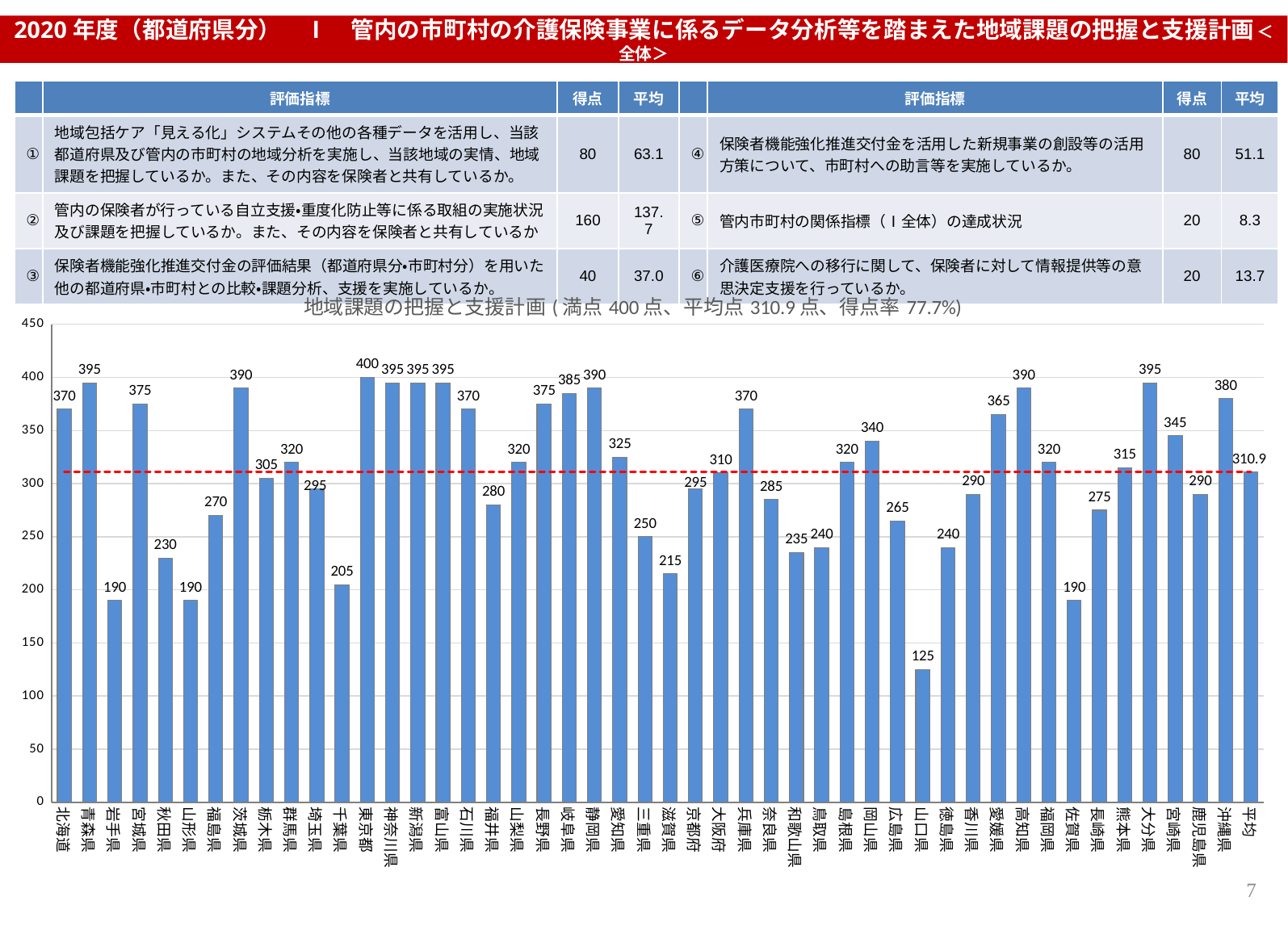
What is the difference between the values for 東京都 and 山口県? 275 Is the value for 滋賀県 greater or less than 250? less What is the value shown for 平均 at the right end of the bar chart? 310.9 What is the 得点率 stated in the chart title? 77.7% Which has a larger value, 岡山県 or 広島県? 岡山県 What kind of chart is shown on the slide? bar chart Which has a larger value, 秋田県 or 福島県? 福島県 What is the value for 東京都 in the bar chart? 400 Which category has the lowest value in the bar chart? 山口県 What is the value for 山口県 in the bar chart? 125 What is the difference between the values for 沖縄県 and 宮崎県? 35 Which category has the highest value in the bar chart? 東京都